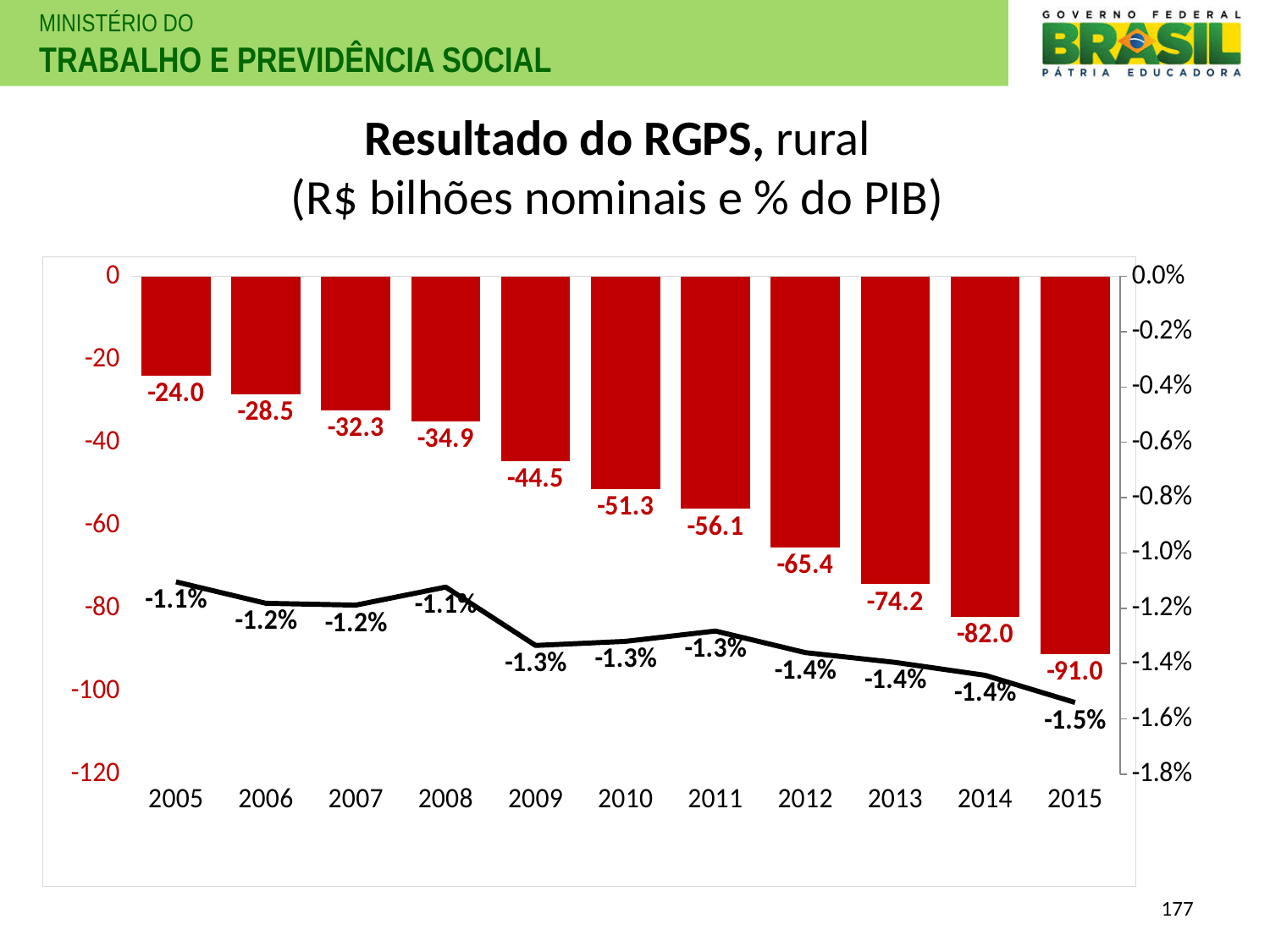
What is the title of the chart? Resultado do RGPS, rural (R$ bilhões nominais e % do PIB) Which bar has the larger magnitude, 2010 or 2011? 2011 What is the value of the bar for 2009? -44.5 Which year has the bar with the smallest magnitude (closest to zero)? 2005 What percentage of PIB is shown on the line for 2015? -1.5% What is the value of the bar for 2015? -91.0 Do the bar values become more negative or less negative from 2005 to 2015? More negative What is the difference between the bar values for 2014 and 2013? 7.8 How many years are shown on the x axis? 11 What kinds of chart are combined on this slide? Bar chart and line chart What percentage of PIB is shown on the line for 2005? -1.1% Which year has the bar with the largest magnitude (most negative value)? 2015